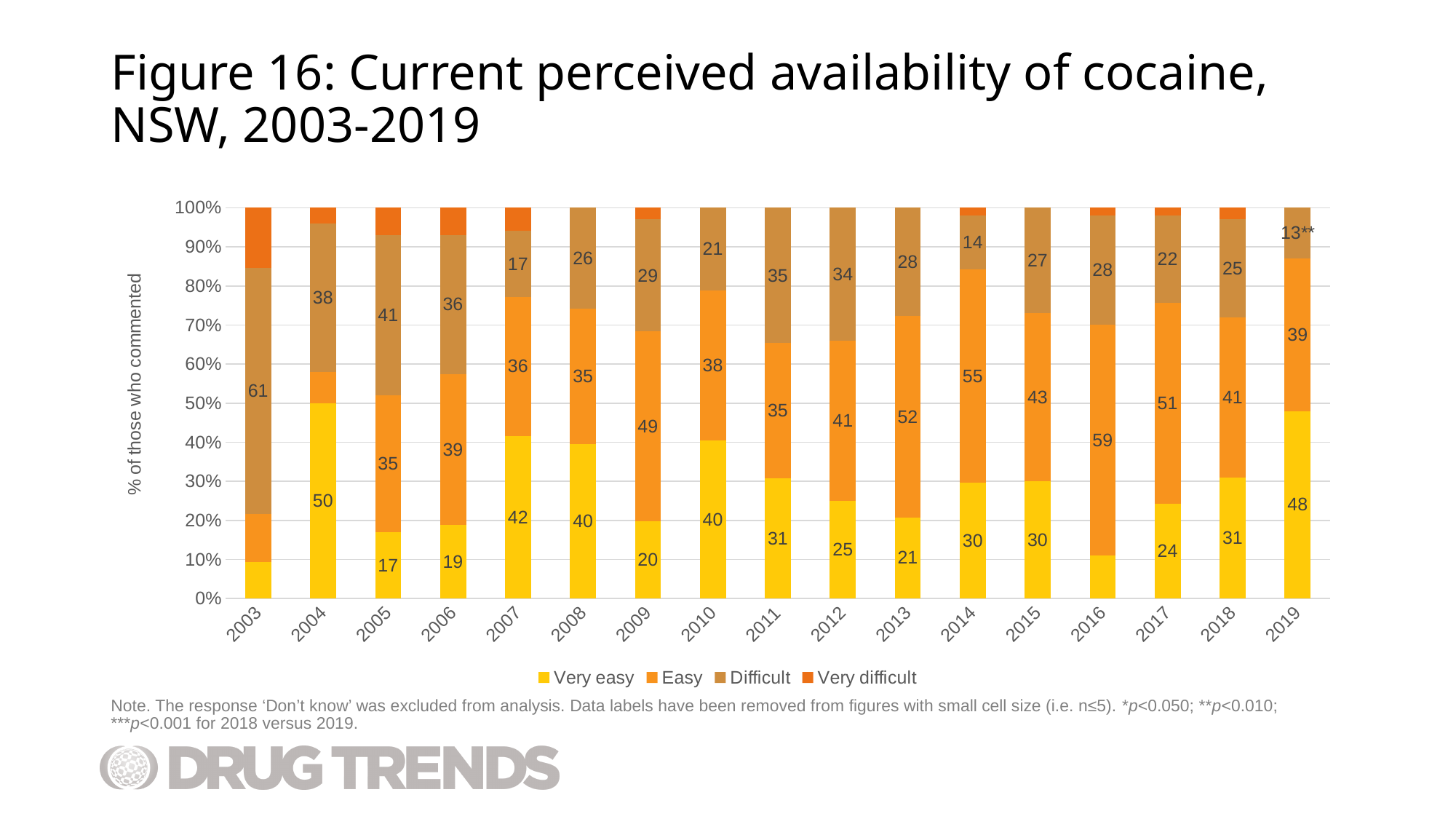
What is the 'Difficult' value for 2003? 61 What is the 'Easy' value for 2016? 59 What is the 'Difficult' value shown for 2019? 13 In 2013, which is larger: the 'Easy' value or the 'Difficult' value? Easy How many years are shown on the x axis? 17 What percentage of respondents rated cocaine as 'Very easy' to obtain in 2004? 50 How many series does the legend list? 4 In which year is the labelled 'Very easy' value highest? 2004 What kind of chart is shown on the slide? Stacked bar chart In which year is the 'Easy' value highest? 2016 By how many percentage points did the 'Very easy' value increase from 2018 to 2019? 17 Does the 'Very easy' value rise or fall from 2017 to 2019? Rise